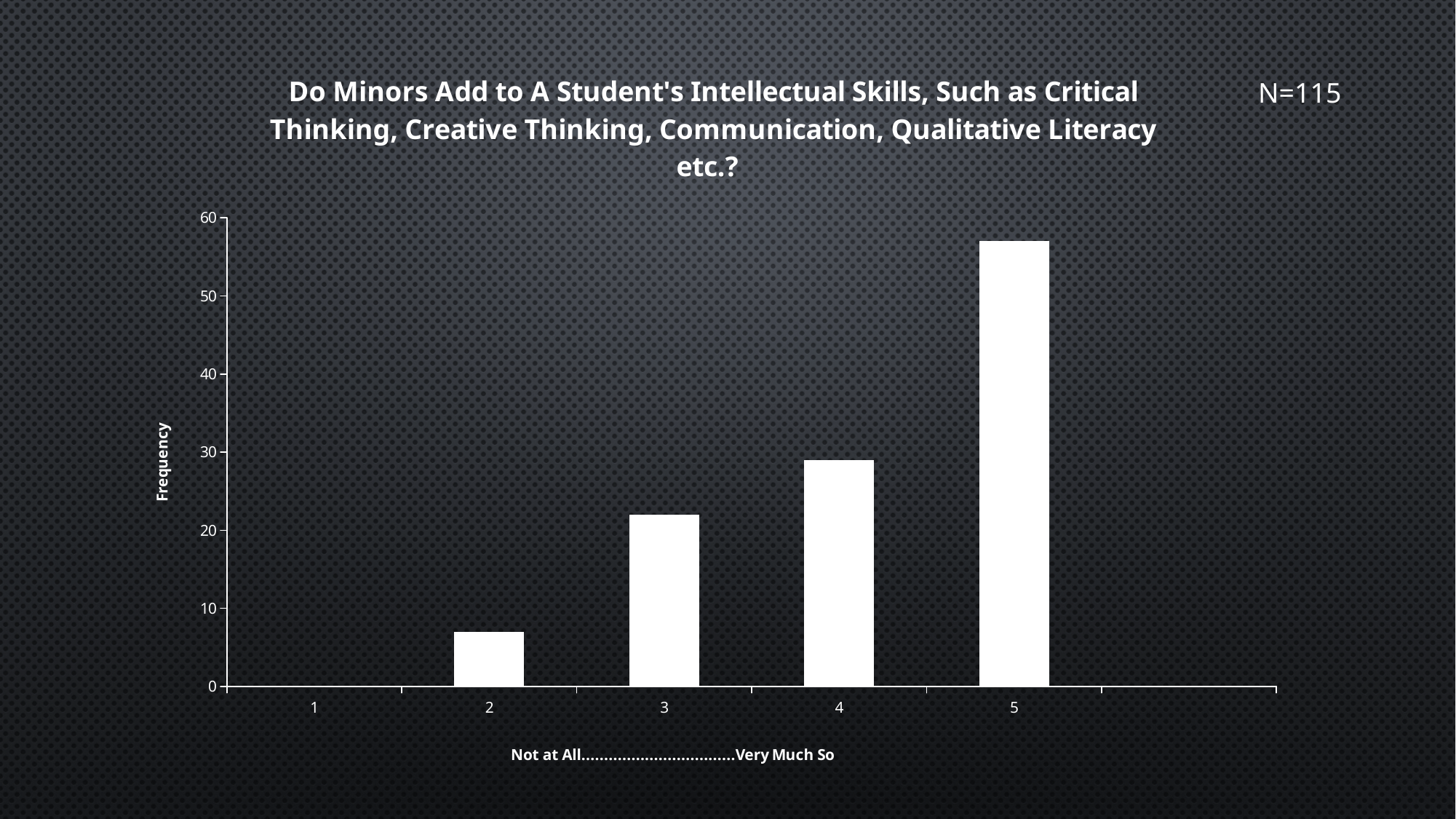
Do the bar values rise or fall from category 1 to category 5? rise Is the value for category 2 greater or less than 10? less Is the value for category 5 greater or less than 50? greater Which has a larger value, category 3 or category 4? 4 What is the label on the y axis? Frequency How many categories are shown on the x axis? 5 What sample size (N) is shown on the slide? N=115 Is the value for category 3 greater or less than 20? greater What kind of chart is shown on the slide? bar chart Among the categories with a visible bar, which has the shortest bar? 2 Which category has the tallest bar? 5